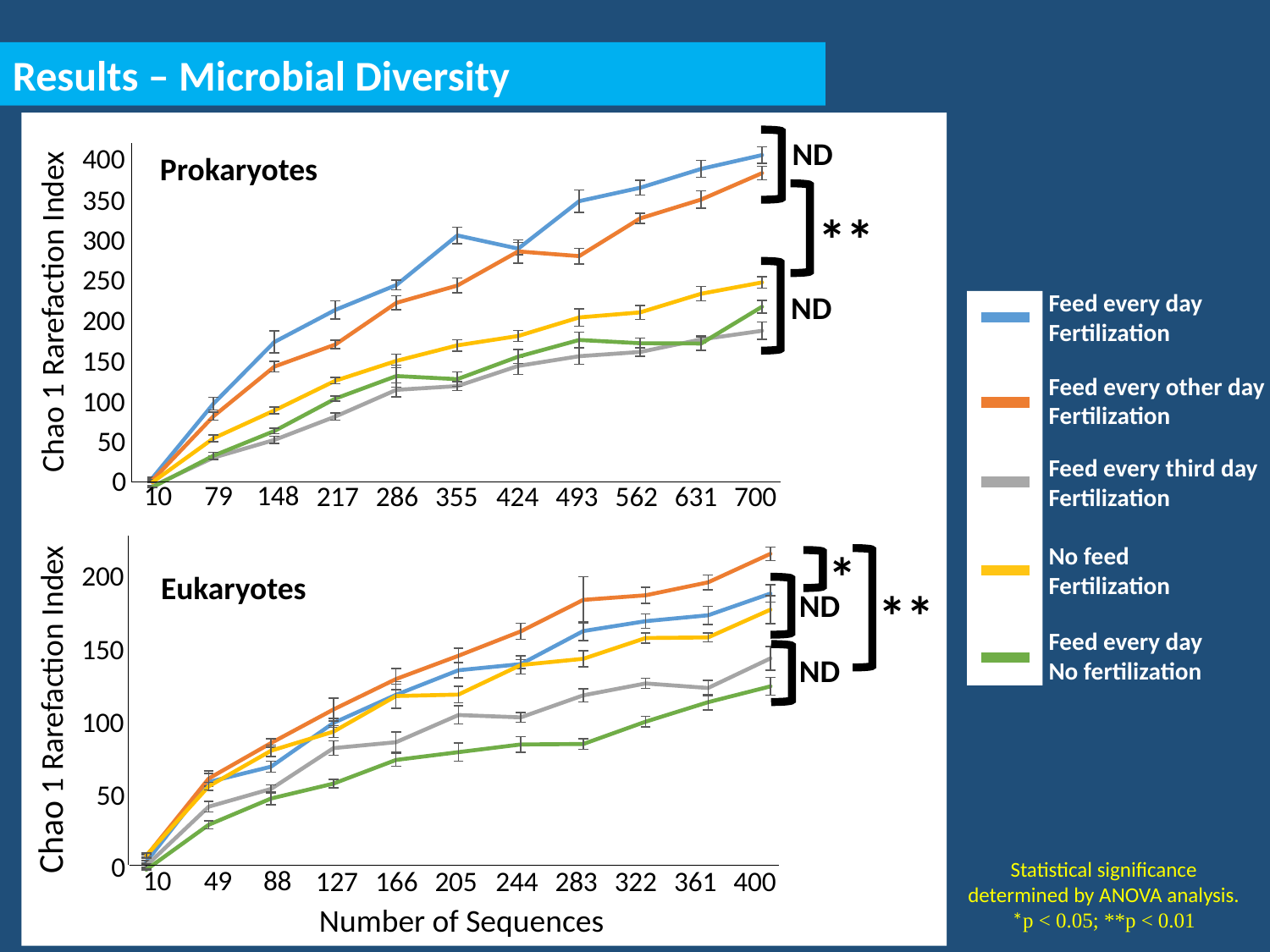
What is the x-axis title shown below the Eukaryotes chart? Number of Sequences In the Eukaryotes chart, is the value for Feed every day No fertilization at 400 sequences greater or less than 150? less What kind of chart is the Prokaryotes chart? line chart In the Prokaryotes chart at 700 sequences, which is larger: Feed every other day Fertilization or No feed Fertilization? Feed every other day Fertilization In the Eukaryotes chart, which series has the highest value at 400 sequences? Feed every other day Fertilization In the Prokaryotes chart, does the Feed every day Fertilization series rise or fall as the number of sequences increases? rise In the Prokaryotes chart, how many x-axis points (number of sequences) are plotted? 11 In the Prokaryotes chart, is the value for Feed every day Fertilization at 700 sequences greater or less than 350? greater How many series does the legend list? 5 In the Prokaryotes chart, which series has the highest value at 700 sequences? Feed every day Fertilization In the Eukaryotes chart, which series has the lowest value at 400 sequences? Feed every day No fertilization In the Prokaryotes chart, which series has the lowest value at 700 sequences? Feed every third day Fertilization